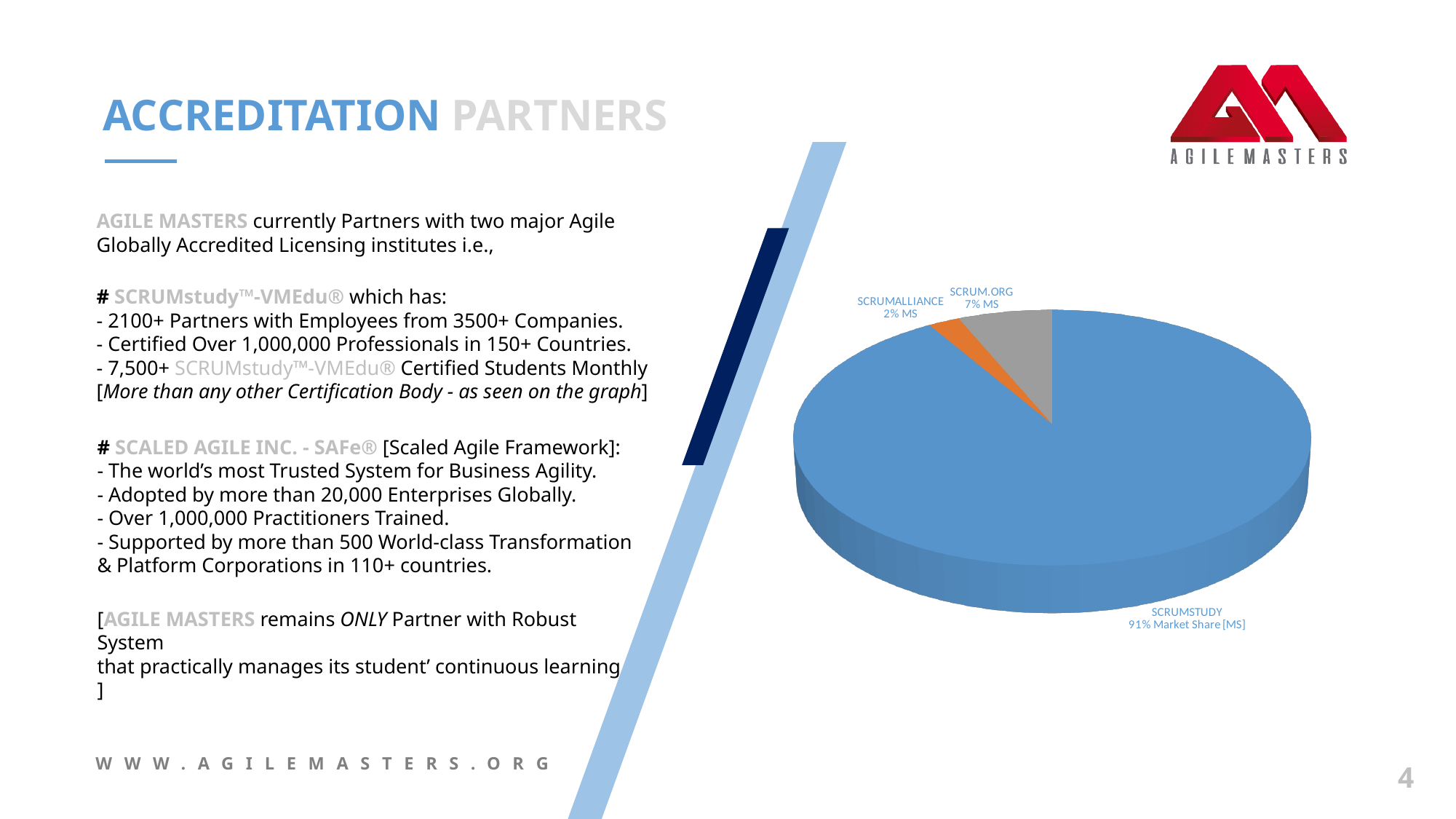
What is the difference in market share between SCRUM.ORG and SCRUMALLIANCE? 5% What market share does the SCRUMALLIANCE slice show? 2% What is the difference in market share between SCRUMSTUDY and SCRUM.ORG? 84% What colour is the SCRUMSTUDY slice in the pie chart? blue Which slice of the pie chart is the largest? SCRUMSTUDY Which has a larger market share, SCRUM.ORG or SCRUMALLIANCE? SCRUM.ORG What colour is the SCRUMALLIANCE slice in the pie chart? orange How many slices does the pie chart have? 3 What kind of chart is shown on the slide? pie chart Which slice of the pie chart is the smallest? SCRUMALLIANCE What market share does the SCRUM.ORG slice show? 7% What market share does the SCRUMSTUDY slice show? 91%